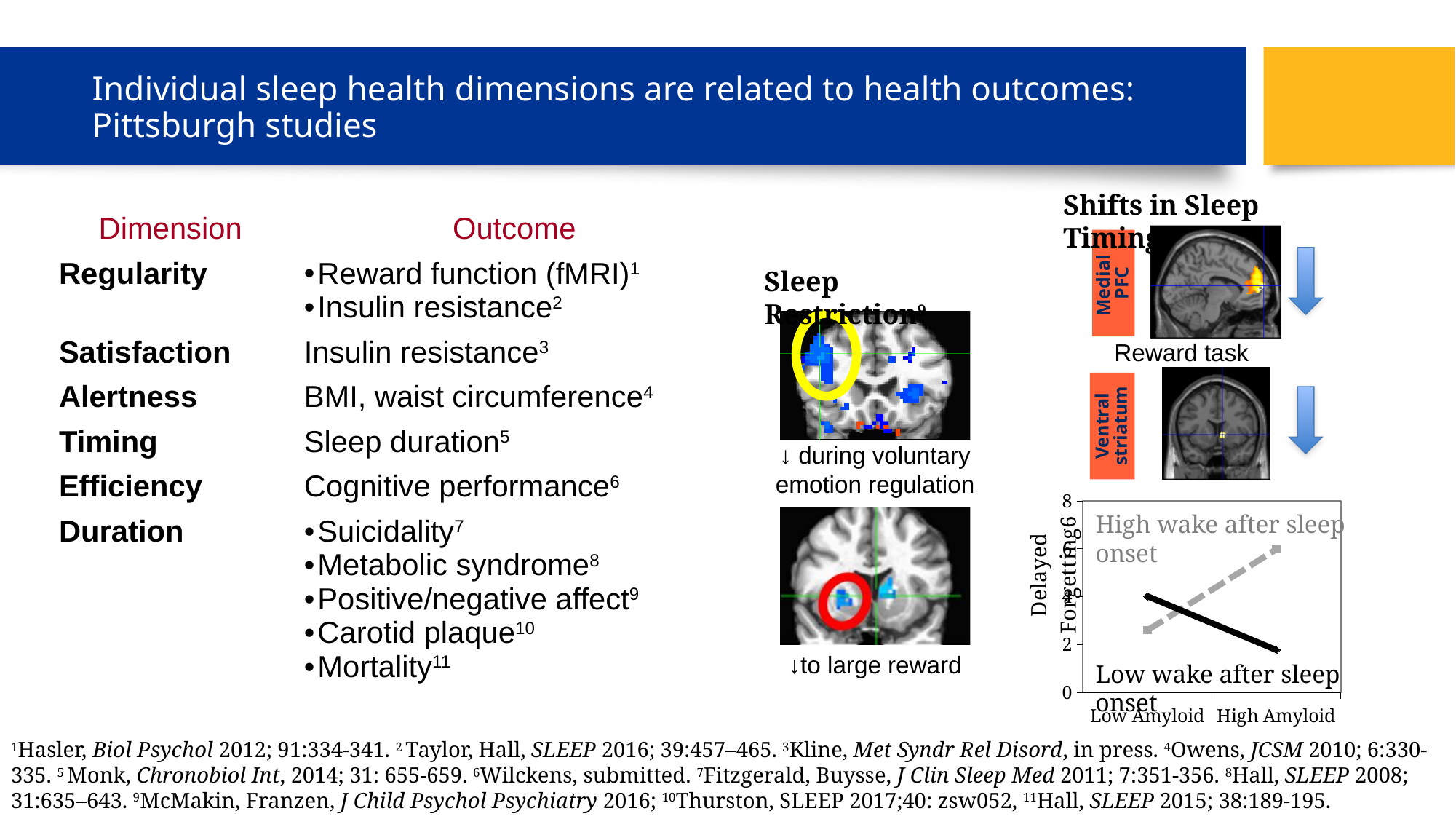
In the line chart at the bottom right, which line is higher at Low Amyloid: 'High wake after sleep onset' or 'Low wake after sleep onset'? Low wake after sleep onset In the line chart at the bottom right, is the value for 'High wake after sleep onset' at Low Amyloid greater or less than 4? less In the line chart at the bottom right, is the value for 'High wake after sleep onset' at High Amyloid greater or less than 4? greater In the line chart at the bottom right, is the value for 'Low wake after sleep onset' at High Amyloid greater or less than 4? less How many categories are shown on the x axis of the line chart at the bottom right? 2 In the line chart at the bottom right, does the 'High wake after sleep onset' line rise or fall from Low Amyloid to High Amyloid? rise What is the label on the y axis of the line chart at the bottom right? Delayed Forgetting What is the highest tick value shown on the y axis of the line chart at the bottom right? 8 What kind of chart is shown at the bottom right of the slide? line chart In the line chart at the bottom right, does the 'Low wake after sleep onset' line rise or fall from Low Amyloid to High Amyloid? fall In the line chart at the bottom right, which line is higher at High Amyloid: 'High wake after sleep onset' or 'Low wake after sleep onset'? High wake after sleep onset